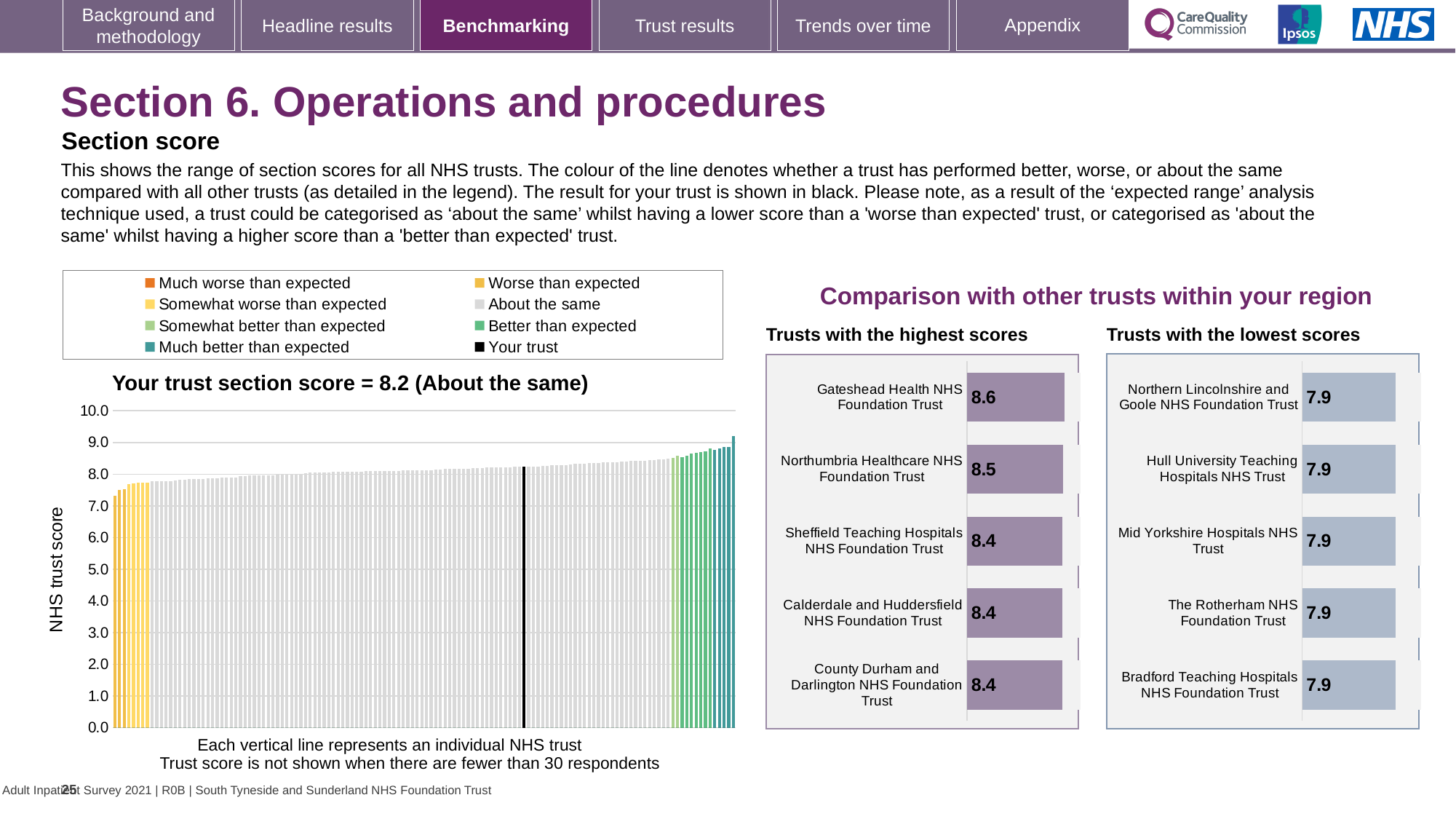
In the 'Trusts with the highest scores' chart, what is the difference between the scores of Gateshead Health NHS Foundation Trust and Sheffield Teaching Hospitals NHS Foundation Trust? 0.2 In the chart titled 'Your trust section score', what is the label on the vertical axis? NHS trust score In the 'Trusts with the highest scores' chart, how many trusts are listed? 5 In the 'Trusts with the highest scores' chart, what is the score for Gateshead Health NHS Foundation Trust? 8.6 In the chart titled 'Your trust section score', is the value of the leftmost bar greater or less than 8.0? less In the chart titled 'Your trust section score', how many entries does the legend list? 8 In the 'Trusts with the highest scores' chart, which trust has the highest score? Gateshead Health NHS Foundation Trust In the chart titled 'Your trust section score', what is the section score for your trust? 8.2 In the chart titled 'Your trust section score', what kind of chart is shown? bar chart In the 'Trusts with the lowest scores' chart, what is the score for Hull University Teaching Hospitals NHS Trust? 7.9 In the 'Trusts with the highest scores' chart, which is larger, the score for Northumbria Healthcare NHS Foundation Trust or the score for Calderdale and Huddersfield NHS Foundation Trust? Northumbria Healthcare NHS Foundation Trust In the chart titled 'Your trust section score', do the bar heights rise or fall from left to right? rise